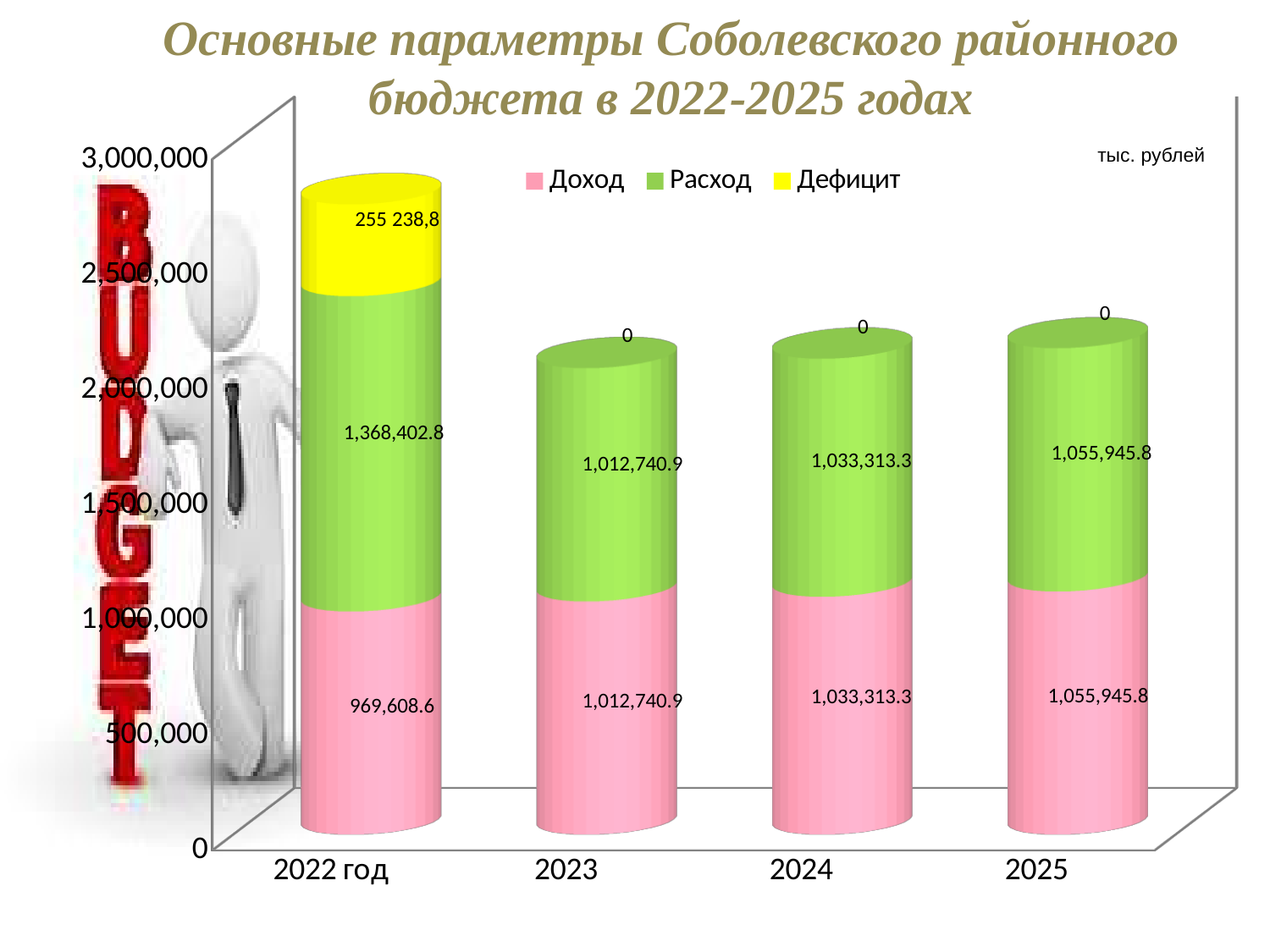
Which year has the highest Расход value? 2022 год What is the total of the stacked bar for 2025? 2,111,891.6 Which year has the lowest Доход value? 2022 год What is the Дефицит value for 2022 год? 255 238,8 What kind of chart is shown on the slide? Stacked bar chart What is the Расход value for 2022 год? 1,368,402.8 Is the Доход value for 2025 larger than the Доход value for 2023? Yes How many years are shown on the x axis? 4 What is the Дефицит value for 2024? 0 How many series does the legend list? 3 What is the Доход value for 2023? 1,012,740.9 What is the difference between Расход and Доход in 2022 год? 398,794.2